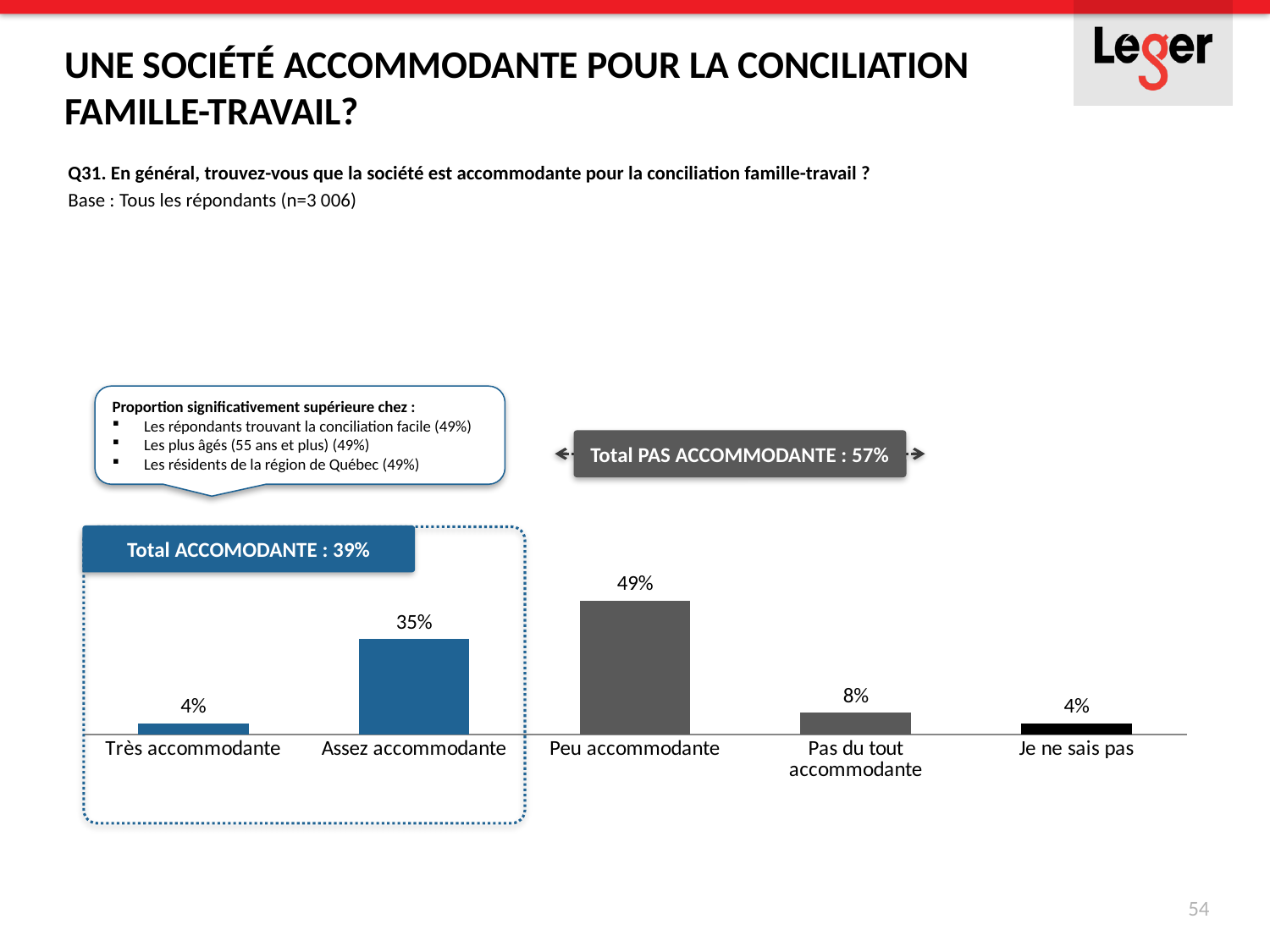
What is the difference between the values for "Peu accommodante" and "Assez accommodante"? 14% What is the total shown for "Total ACCOMODANTE"? 39% What is the value for "Peu accommodante"? 49% What is the difference between the values for "Pas du tout accommodante" and "Je ne sais pas"? 4% Which is larger, the value for "Assez accommodante" or the value for "Pas du tout accommodante"? Assez accommodante What kind of chart is shown on the slide? Bar chart How many categories are shown on the x axis? 5 What is the value for "Pas du tout accommodante"? 8% What is the value for "Assez accommodante"? 35% What is the total shown for "Total PAS ACCOMMODANTE"? 57% Which category has the highest value? Peu accommodante What is the value for "Très accommodante"? 4%